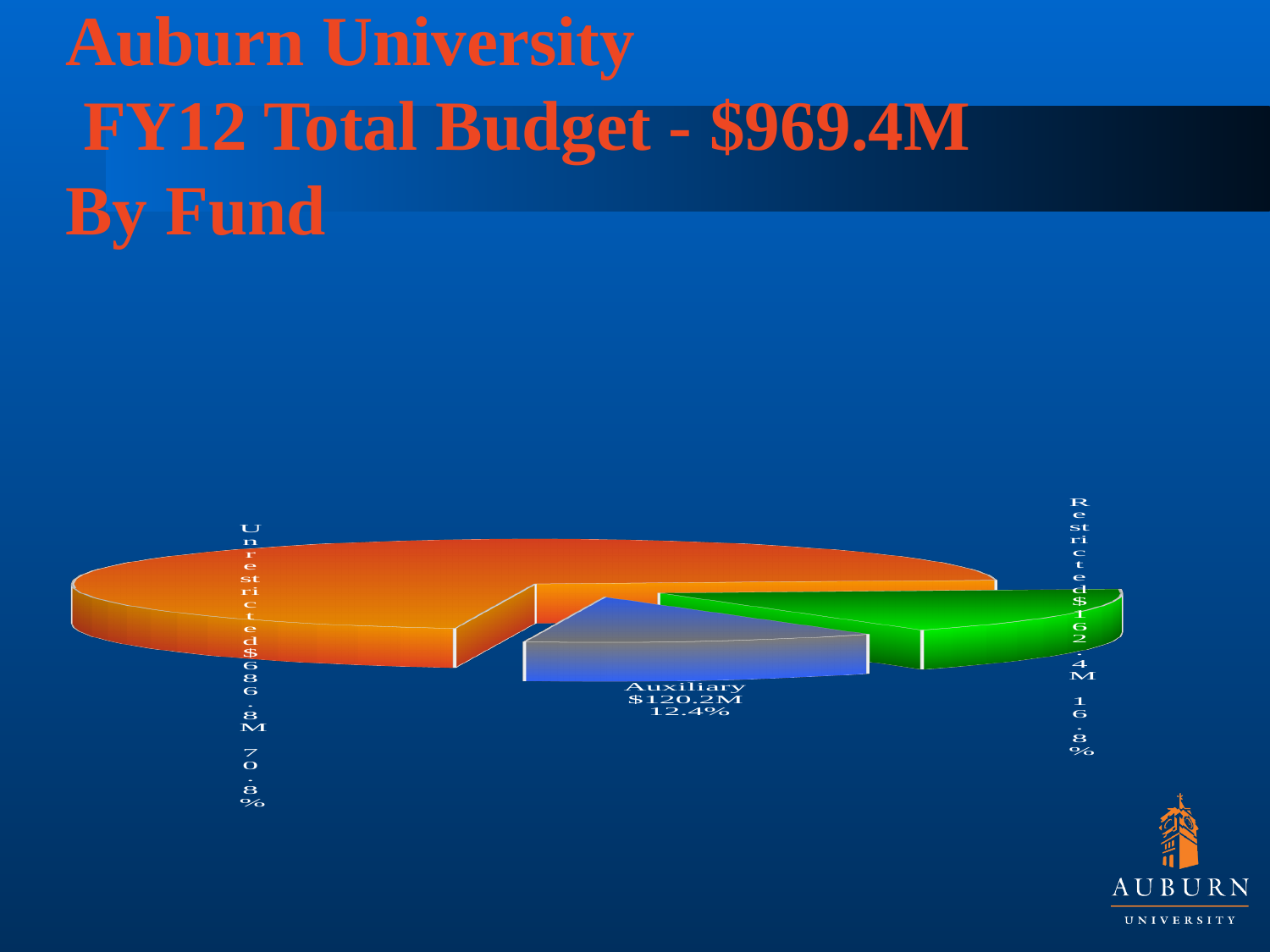
How many slices does the pie chart have? 3 What kind of chart is shown on the slide? Pie chart What is the dollar value of the Restricted slice? $162.4M What is the dollar value of the Unrestricted slice? $686.8M What share of the pie does the Unrestricted slice represent? 70.8% Which fund has the smallest slice of the pie? Auxiliary Which fund has the largest slice of the pie? Unrestricted What is the dollar value of the Auxiliary slice? $120.2M What total budget figure is given in the slide title? $969.4M What share of the pie does the Auxiliary slice represent? 12.4% Which is larger, the Restricted slice or the Auxiliary slice? Restricted What share of the pie does the Restricted slice represent? 16.8%